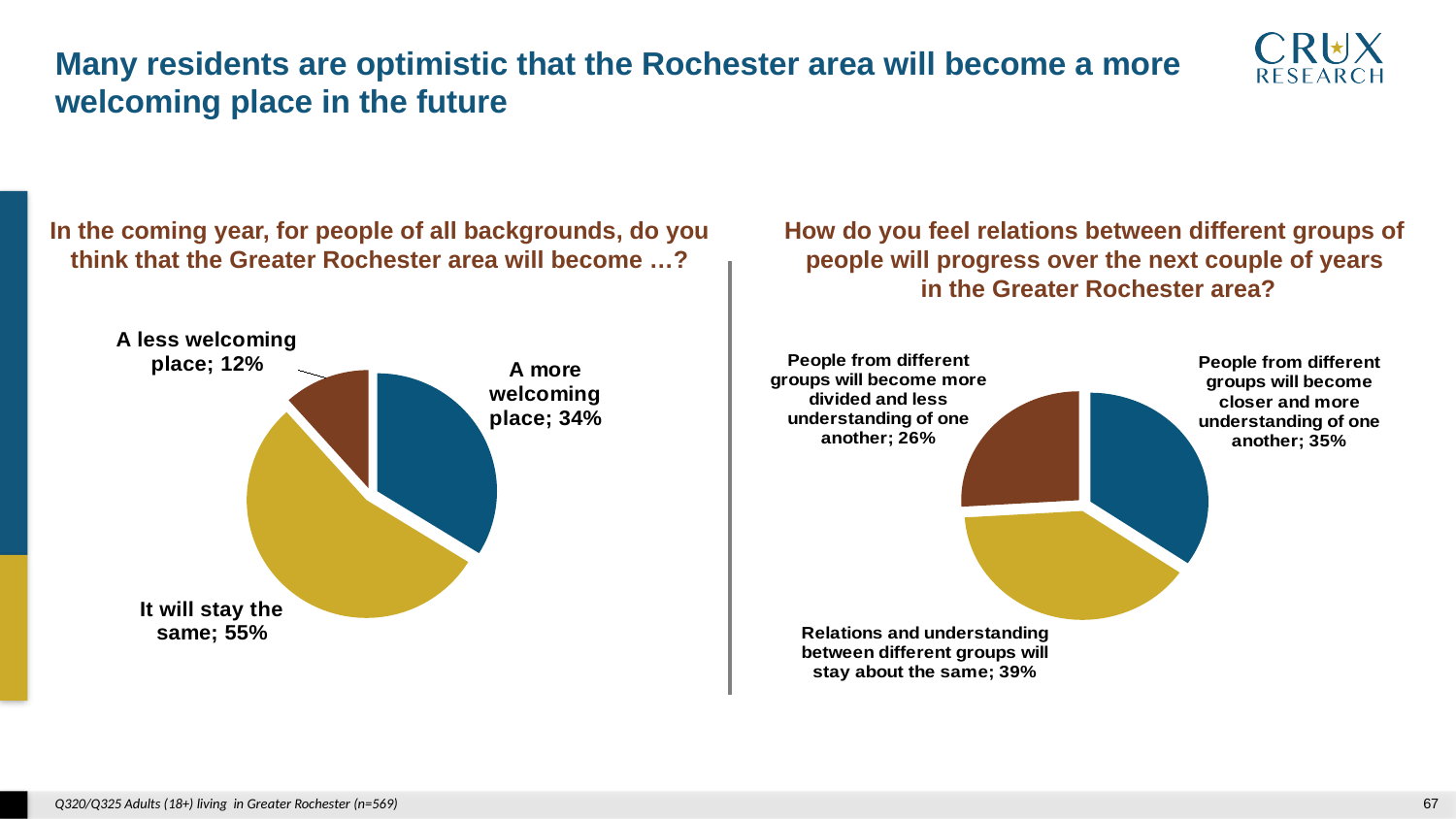
How many slices does the right pie chart have? 3 On the left pie chart, which response has the smallest share? A less welcoming place On the right pie chart, which response has the smallest share? People from different groups will become more divided and less understanding of one another On the left pie chart, what is the difference in percentage points between 'It will stay the same' and 'A more welcoming place'? 21 On the left pie chart, what share of respondents said the Greater Rochester area will become a more welcoming place? 34% On the left pie chart, what share of respondents said it will stay the same? 55% On the right pie chart, what share of respondents said relations and understanding between different groups will stay about the same? 39% On the right pie chart, what share of respondents said people from different groups will become closer and more understanding of one another? 35% On the left pie chart, which response has the largest share? It will stay the same On the right pie chart, what share of respondents said people from different groups will become more divided and less understanding of one another? 26% On the left pie chart, what share of respondents said the area will become a less welcoming place? 12% What type of chart is used on the left side of the slide? Pie chart